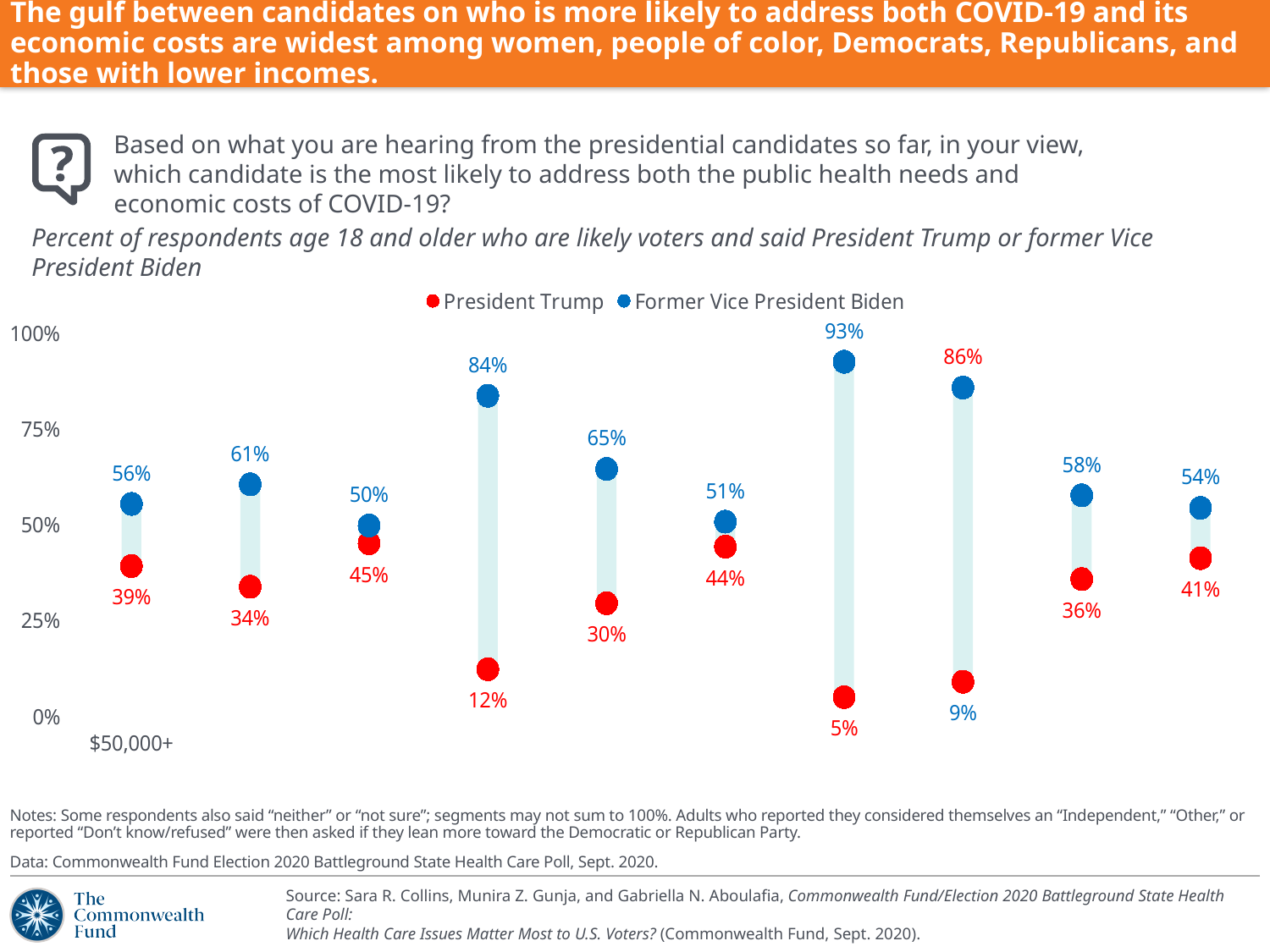
What kind of chart is this? Dot plot In the leftmost group, what is the value for Former Vice President Biden? 56% In the fourth group from the left, what is the difference between the Biden value (84%) and the Trump value (12%)? 72 percentage points Which colour represents President Trump in the legend? Red In the rightmost group, is the value for President Trump greater or less than 50%? less In the leftmost group, what is the value for President Trump? 39% What is the highest value shown for Former Vice President Biden? 93% In the fourth group from the left, which candidate has the higher value? Former Vice President Biden How many series does the legend list? 2 How many groups of paired data points are plotted on the chart? 10 What is the lowest value shown for President Trump? 5% In the leftmost group, what is the difference between the Biden value and the Trump value? 17 percentage points